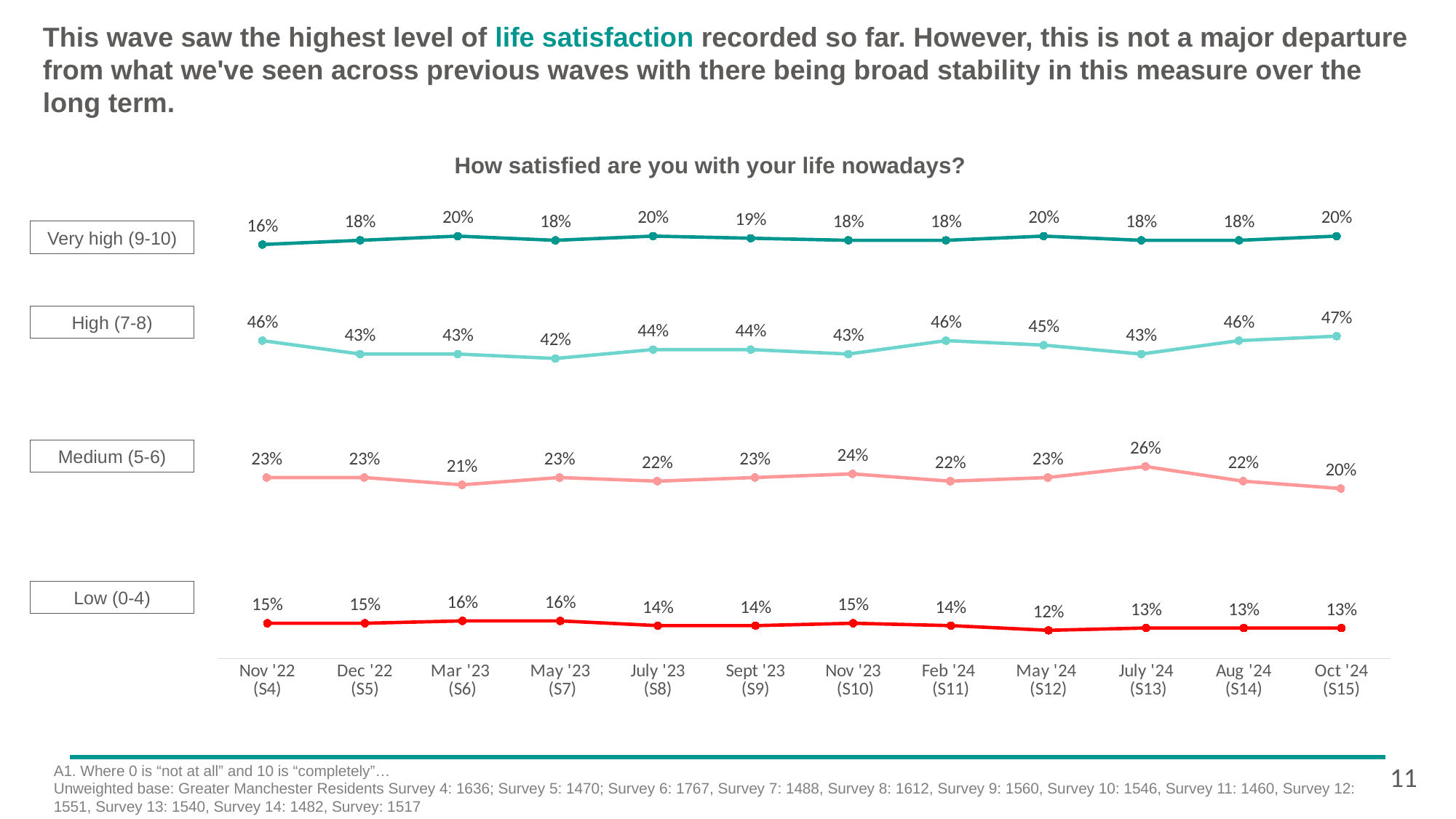
What is the value for High (7-8) in Oct '24 (S15)? 47% What is the difference between the Medium (5-6) value in July '24 (S13) and in Oct '24 (S15)? 6 percentage points What is the value for Low (0-4) in May '24 (S12)? 12% What is the title of the chart? How satisfied are you with your life nowadays? In which wave is the Very high (9-10) series at its lowest? Nov '22 (S4) What kind of chart is shown on the slide? Line chart How many survey waves are shown on the x axis? 12 What is the value for Medium (5-6) in July '24 (S13)? 26% How many series are plotted on the chart? 4 In which wave is the High (7-8) series at its highest? Oct '24 (S15) Does the Low (0-4) series rise or fall from Nov '22 (S4) to Oct '24 (S15)? Fall Which is larger in Nov '23 (S10): the Medium (5-6) value or the Low (0-4) value? Medium (5-6)